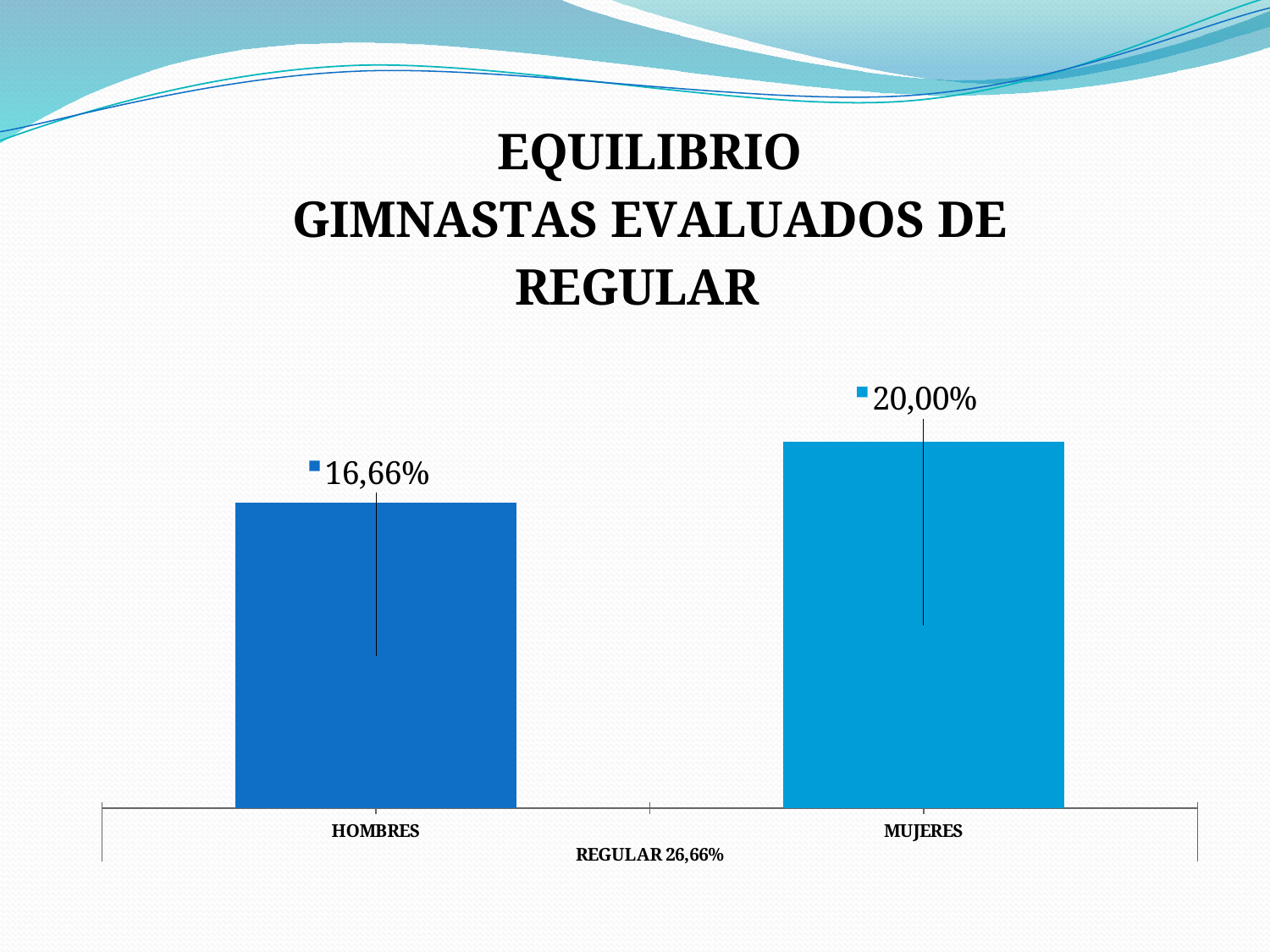
Which category has the highest value? MUJERES What is the value for MUJERES? 20,00% What is the difference between the values for MUJERES and HOMBRES? 3,34% What is the title of the slide? EQUILIBRIO GIMNASTAS EVALUADOS DE REGULAR What is the label shown below the category axis of the chart? REGULAR 26,66% How many categories are shown in the chart? 2 What kind of chart is shown on the slide? Bar chart Which category has the lowest value? HOMBRES What is the value for HOMBRES? 16,66% Which is larger, the value for HOMBRES or the value for MUJERES? MUJERES